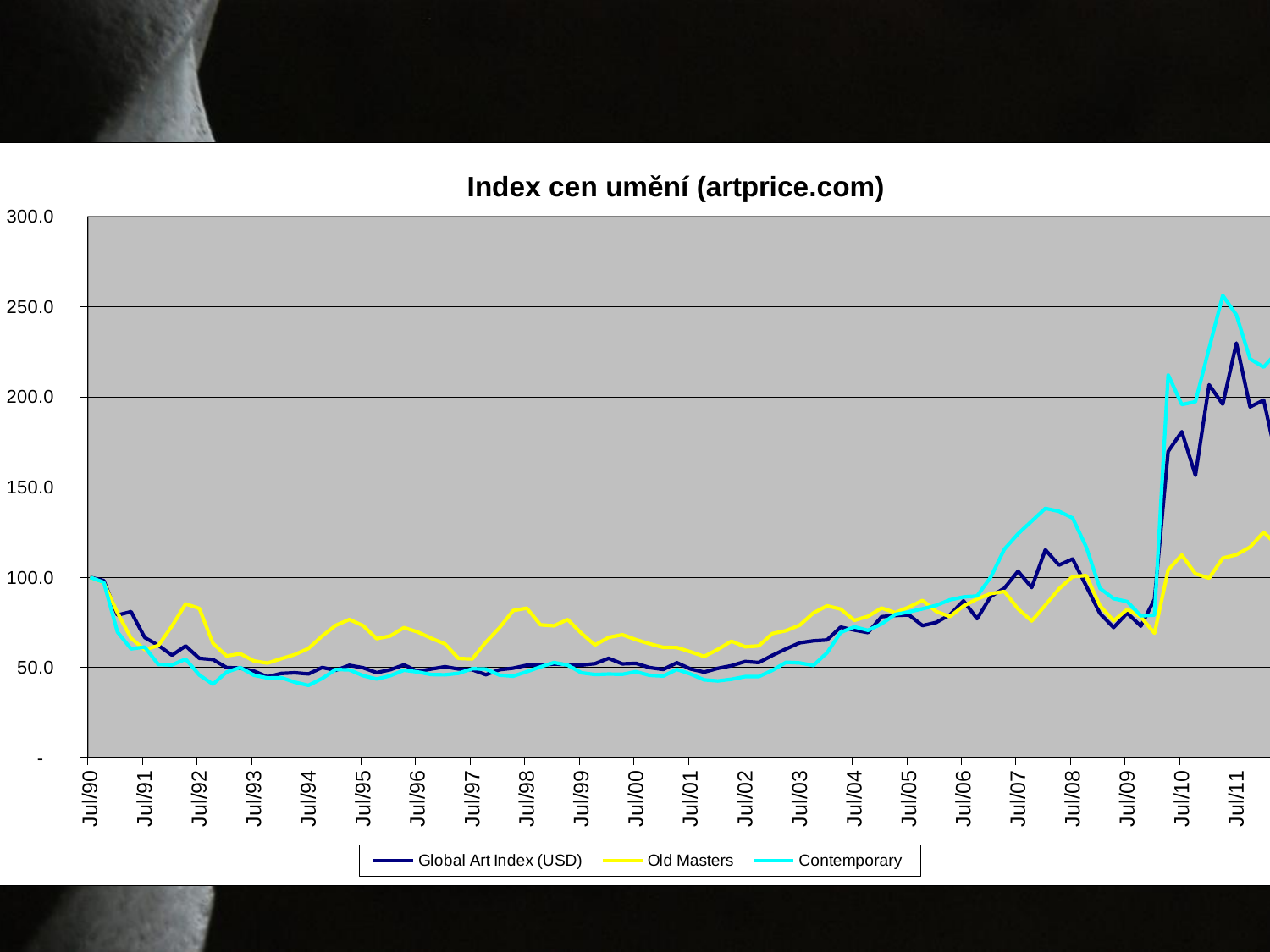
How many year labels are shown on the x axis? 22 Is the value for Old Masters at Jul/11 greater or less than 100.0? greater Is the peak value of the Contemporary series greater or less than 200.0? greater Which colour is used for the Contemporary series? light blue (cyan) At Jul/07, which is higher: Contemporary or Old Masters? Contemporary Is the value for Contemporary at Jul/92 greater or less than 50.0? less What type of chart is shown on the slide? line chart Which series reaches the highest value on the chart? Contemporary How many series does the legend list? 3 Does the Contemporary series rise or fall between Jul/09 and Jul/10? rise What is the value of the Global Art Index (USD) at Jul/90? 100.0 What is the title of the chart? Index cen umění (artprice.com)